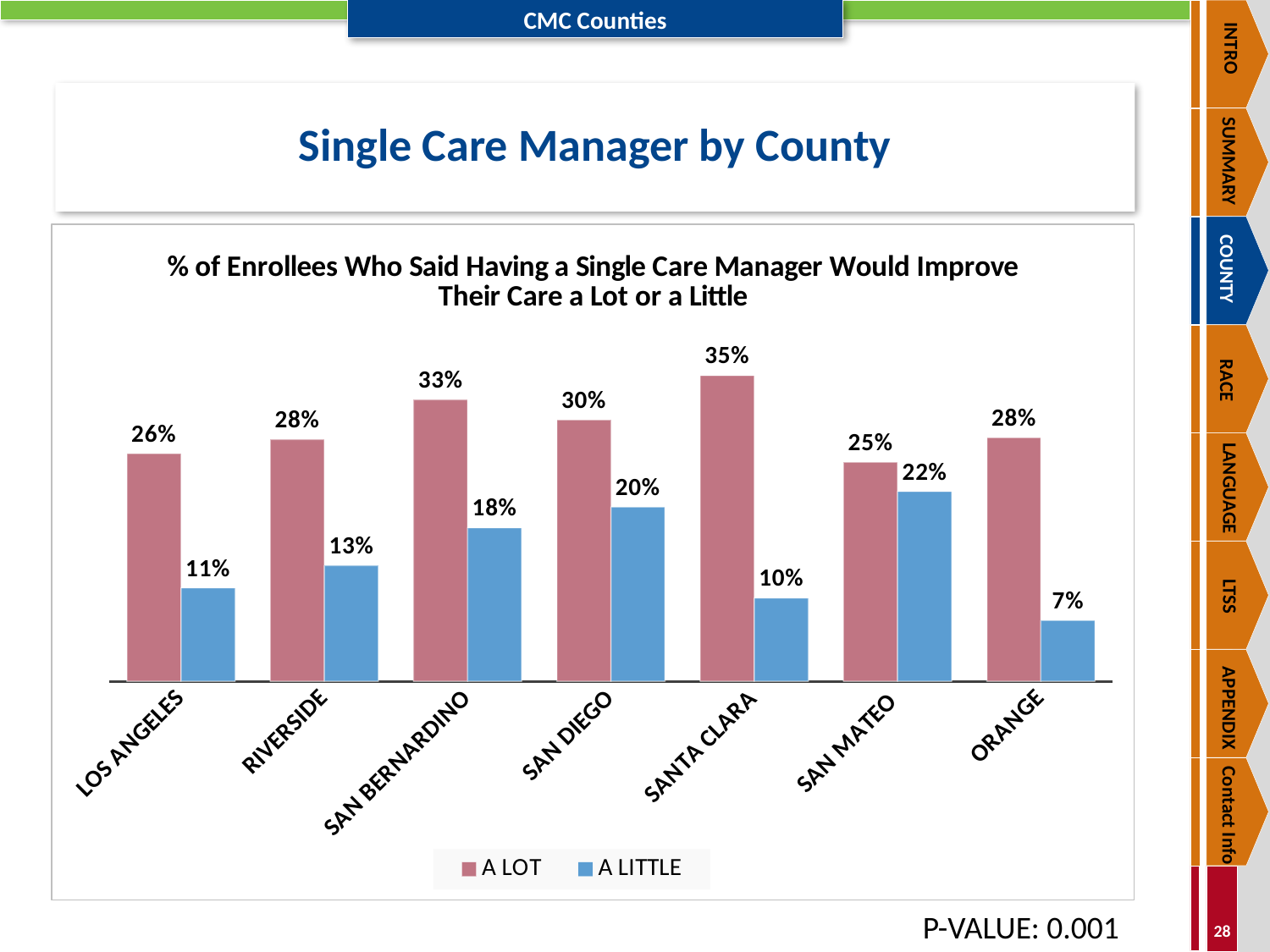
How many counties are shown on the x axis? 7 What is the difference between the 'A LOT' and 'A LITTLE' values for Orange? 21% What is the 'A LOT' value for Los Angeles? 26% What are the two series named in the legend? A LOT and A LITTLE How many series does the legend list? 2 What percentage of Santa Clara enrollees said a single care manager would improve their care a lot? 35% What kind of chart is shown on the slide? Bar chart Which is larger: the 'A LITTLE' value for San Diego or the 'A LITTLE' value for Riverside? San Diego What is the 'A LITTLE' value for San Mateo? 22% Which county has the highest 'A LOT' value? Santa Clara What is the difference between the 'A LOT' values for Santa Clara and San Mateo? 10% Which county has the lowest 'A LITTLE' value? Orange